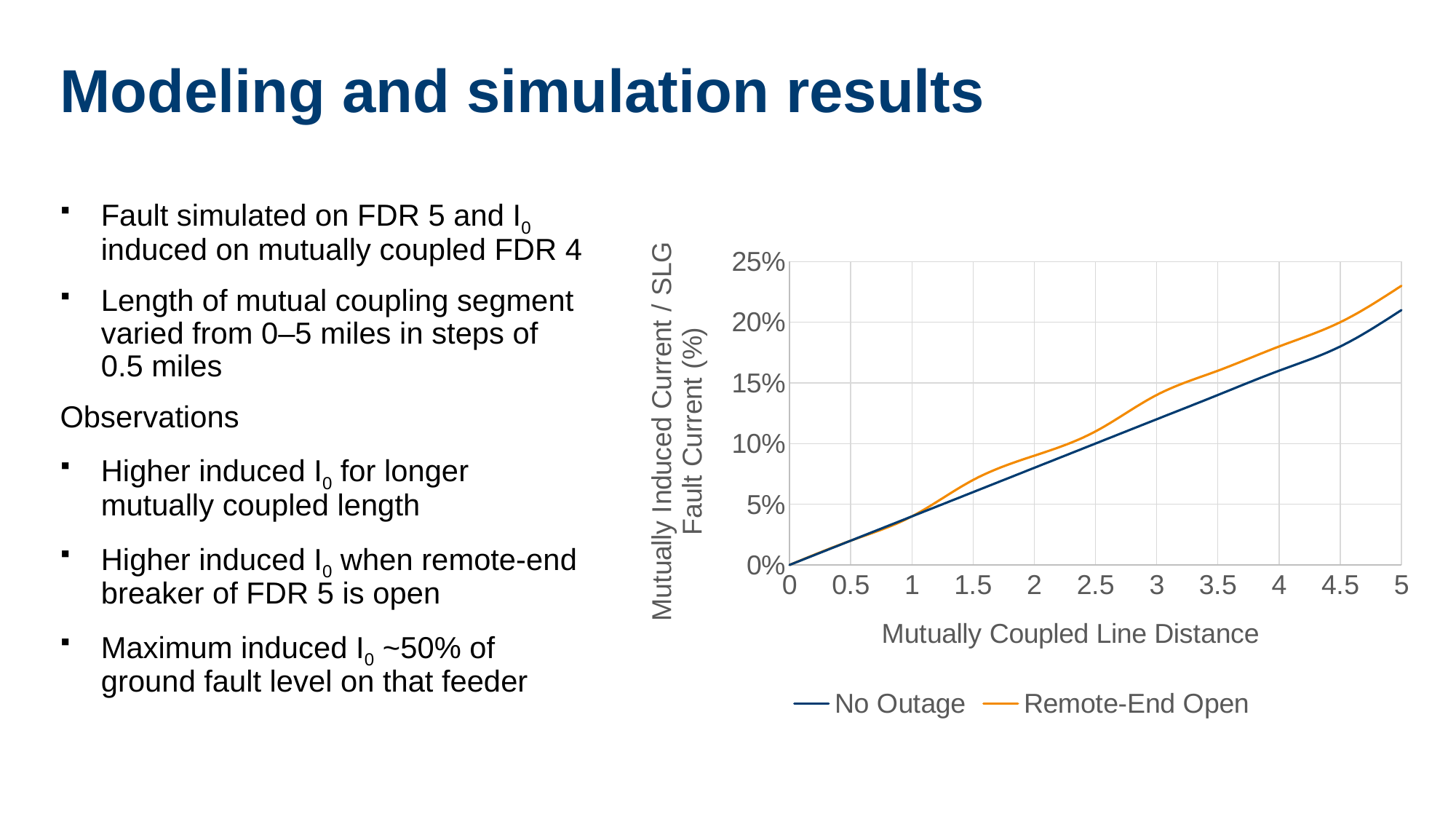
Is the value for No Outage at a distance of 5 greater or less than 20%? greater What is the title of the x axis? Mutually Coupled Line Distance What is the value for both series at a mutually coupled line distance of 0? 0% Is the value for Remote-End Open at a distance of 5 greater or less than 20%? greater Is the value for No Outage at a distance of 1 greater or less than 5%? less What kind of chart is shown on the slide? line chart Do the values for No Outage rise or fall as the mutually coupled line distance increases? rise At a mutually coupled line distance of 5, which series has the higher value, No Outage or Remote-End Open? Remote-End Open How many series does the chart legend list? 2 Which series is plotted in orange? Remote-End Open